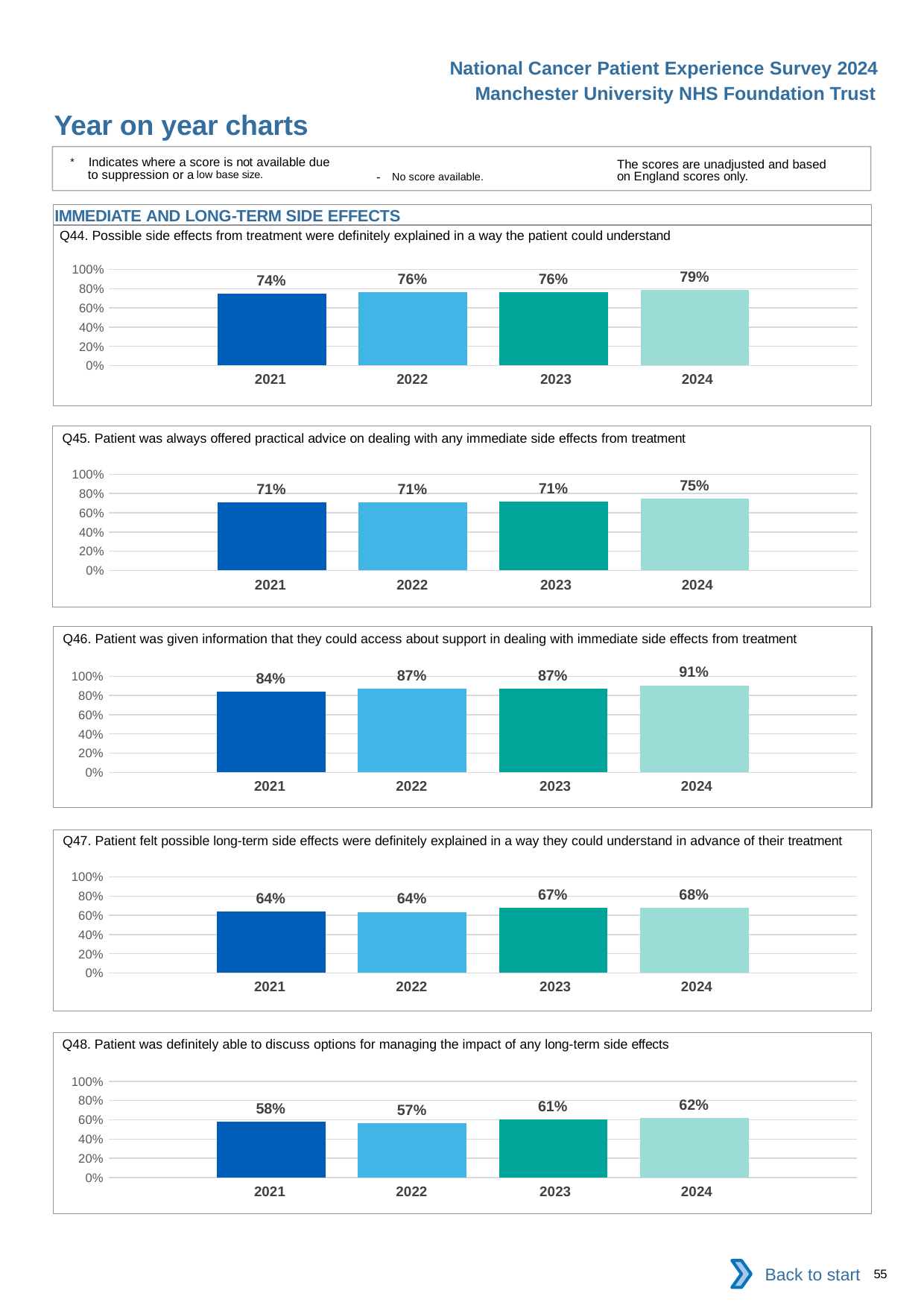
In the Q44 chart, what is the value for 2024? 79% In the Q47 chart, what is the difference between the 2024 and 2021 values? 4% In the Q48 chart, which year has the lowest value? 2022 In the Q48 chart, which is larger, the value for 2021 or the value for 2023? 2023 In the Q46 chart, what is the difference between the 2024 and 2021 values? 7% In the Q45 chart, what is the value for 2022? 71% In the Q46 chart, which year has the highest value? 2024 How many years are shown in the Q44 chart? 4 How many charts are shown on the slide? 5 In the Q46 chart, do the values rise or fall from 2021 to 2024? rise What kind of chart is used for Q45? bar chart In the Q47 chart, is the value for 2023 greater or less than 60%? greater